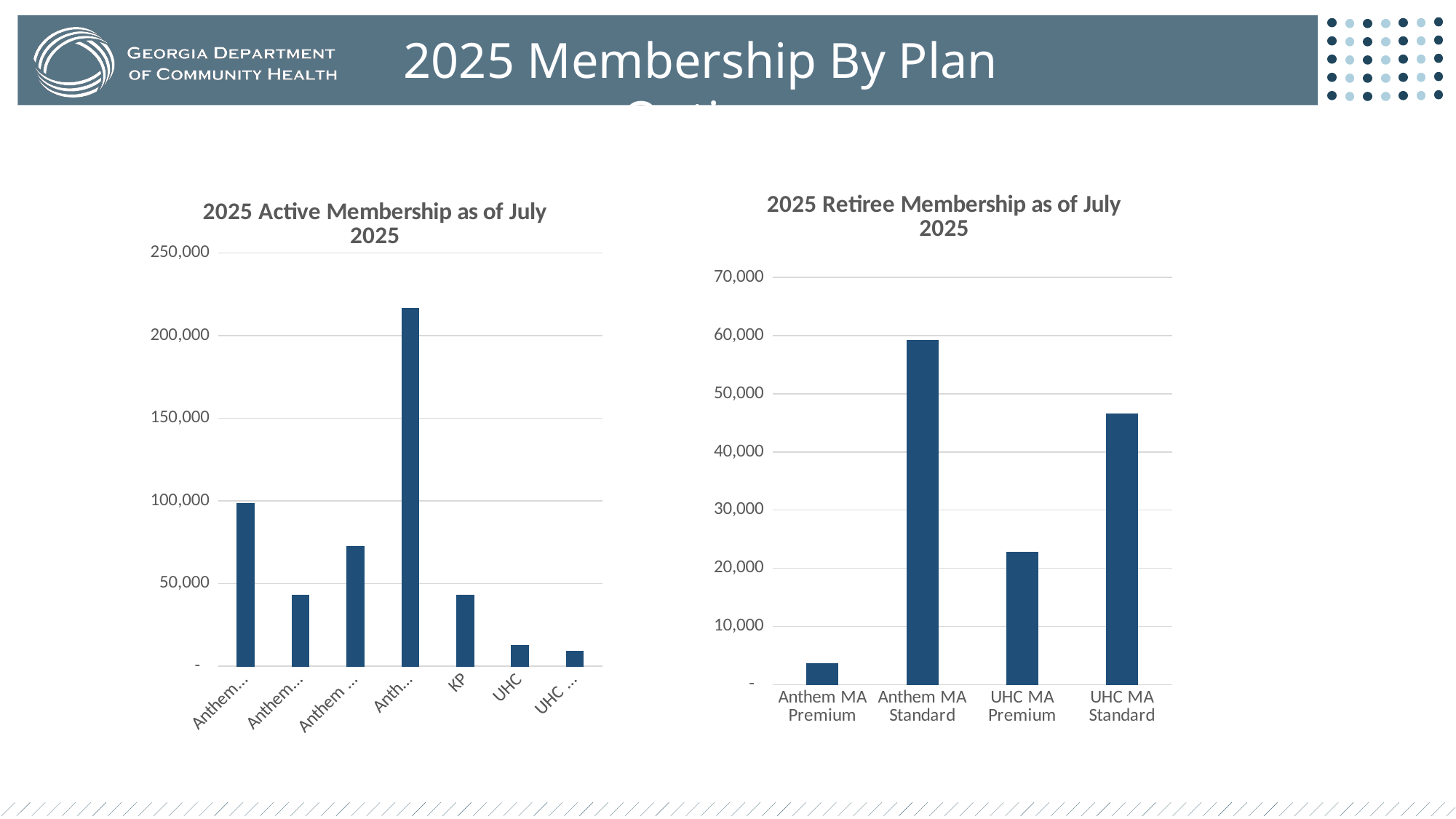
On the 2025 Retiree Membership chart, is the value for Anthem MA Premium greater or less than 10,000? less On the 2025 Retiree Membership chart, which is larger, UHC MA Standard or UHC MA Premium? UHC MA Standard How many bars are shown on the 2025 Active Membership chart? 7 On the 2025 Retiree Membership chart, is the value for UHC MA Premium greater or less than 30,000? less What kind of chart is the 2025 Active Membership chart? Bar chart On the 2025 Retiree Membership chart, which plan has the lowest membership? Anthem MA Premium On the 2025 Active Membership chart, is the value for KP greater or less than 50,000? less What is the title of the chart on the right side of the slide? 2025 Retiree Membership as of July 2025 How many plans are shown on the 2025 Retiree Membership chart? 4 On the 2025 Retiree Membership chart, which plan has the highest membership? Anthem MA Standard On the 2025 Active Membership chart, which is larger, KP or UHC? KP